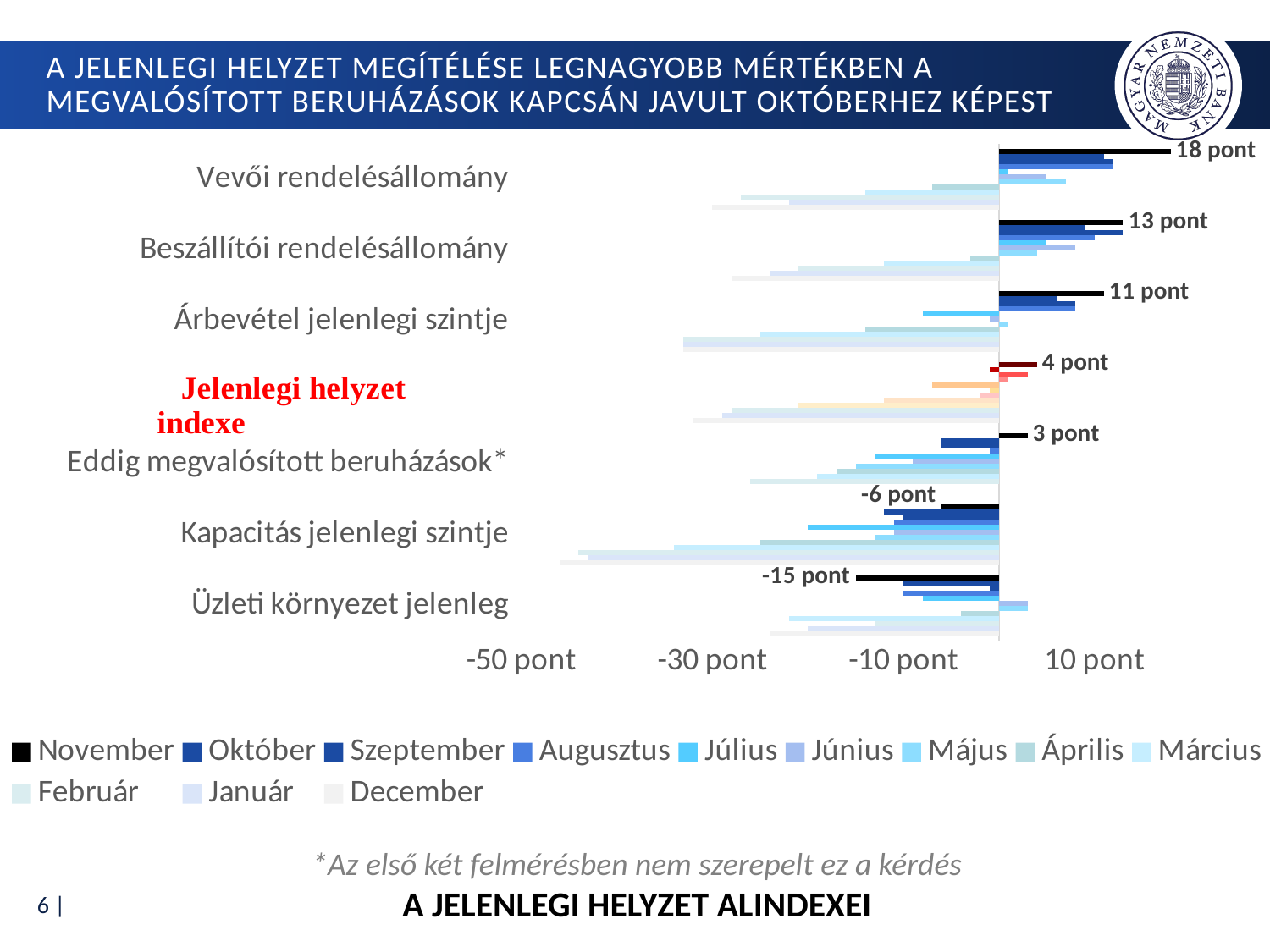
What kind of chart is shown on the slide? Bar chart What is the November value for Vevői rendelésállomány? 18 pont What is the November value for Árbevétel jelenlegi szintje? 11 pont Which category has the lowest November value? Üzleti környezet jelenleg What is the November value for Jelenlegi helyzet indexe? 4 pont How many categories are shown on the chart? 7 How many series does the legend list? 12 Which category has the highest November value? Vevői rendelésállomány What is the November value for Beszállítói rendelésállomány? 13 pont What is the difference between the November values for Vevői rendelésállomány and Beszállítói rendelésállomány? 5 pont What is the November value for Üzleti környezet jelenleg? -15 pont Which has a larger November value, Eddig megvalósított beruházások* or Kapacitás jelenlegi szintje? Eddig megvalósított beruházások*